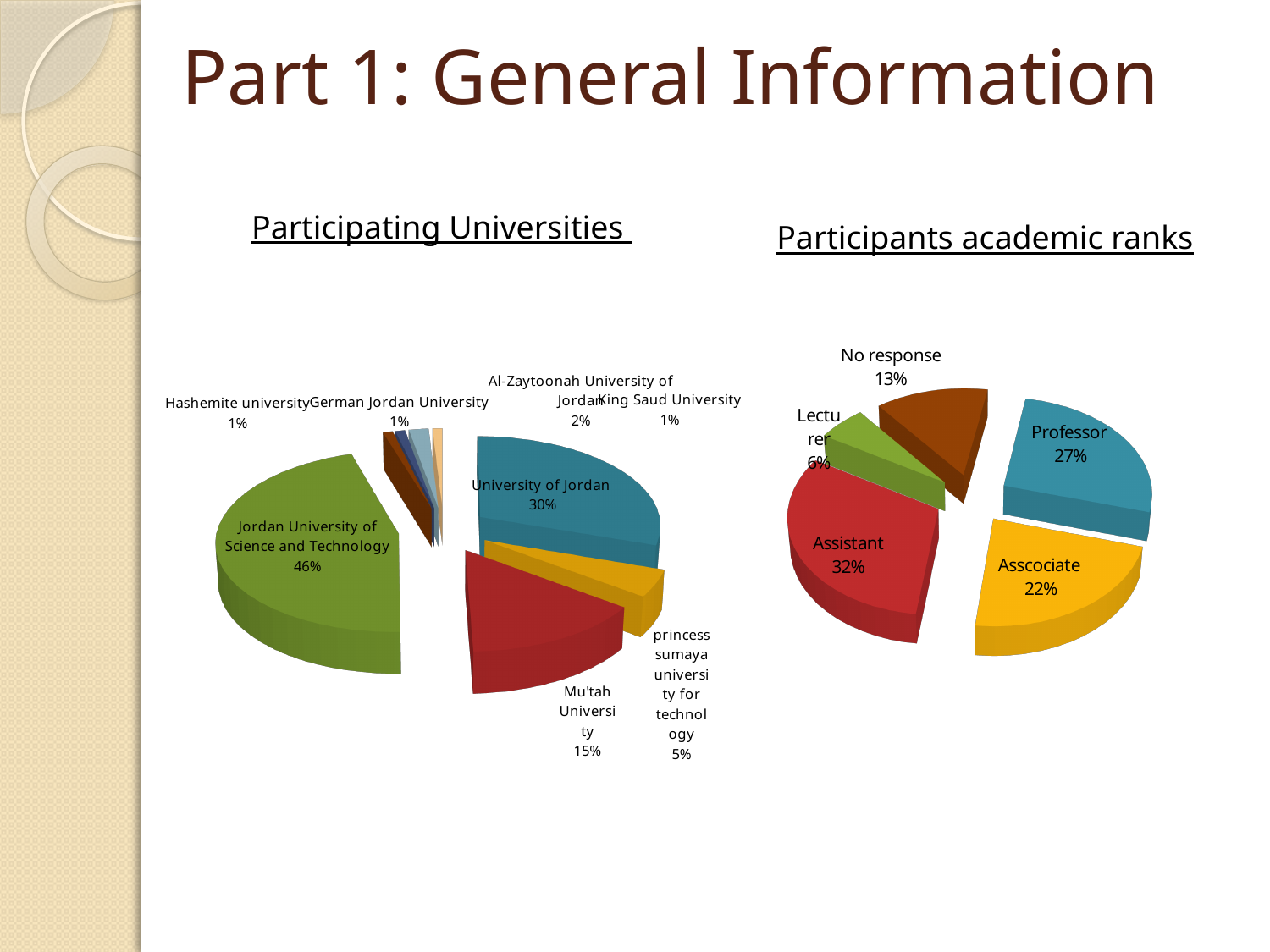
In the Participants academic ranks chart, how many categories are shown? 5 In the Participating Universities chart, what percentage is shown for Mu'tah University? 15% What kind of chart is the Participants academic ranks chart? Pie chart In the Participating Universities chart, how many universities are shown? 8 In the Participants academic ranks chart, which rank has the smallest share? Lecturer In the Participants academic ranks chart, which is larger, Professor or Asscociate? Professor In the Participating Universities chart, what share does Jordan University of Science and Technology have? 46% In the Participating Universities chart, which university has the largest share? Jordan University of Science and Technology In the Participants academic ranks chart, what percentage is shown for No response? 13% In the Participants academic ranks chart, what percentage is shown for Assistant? 32% In the Participating Universities chart, what is the difference between the shares of University of Jordan and Mu'tah University? 15% In the Participating Universities chart, what percentage is shown for University of Jordan? 30%